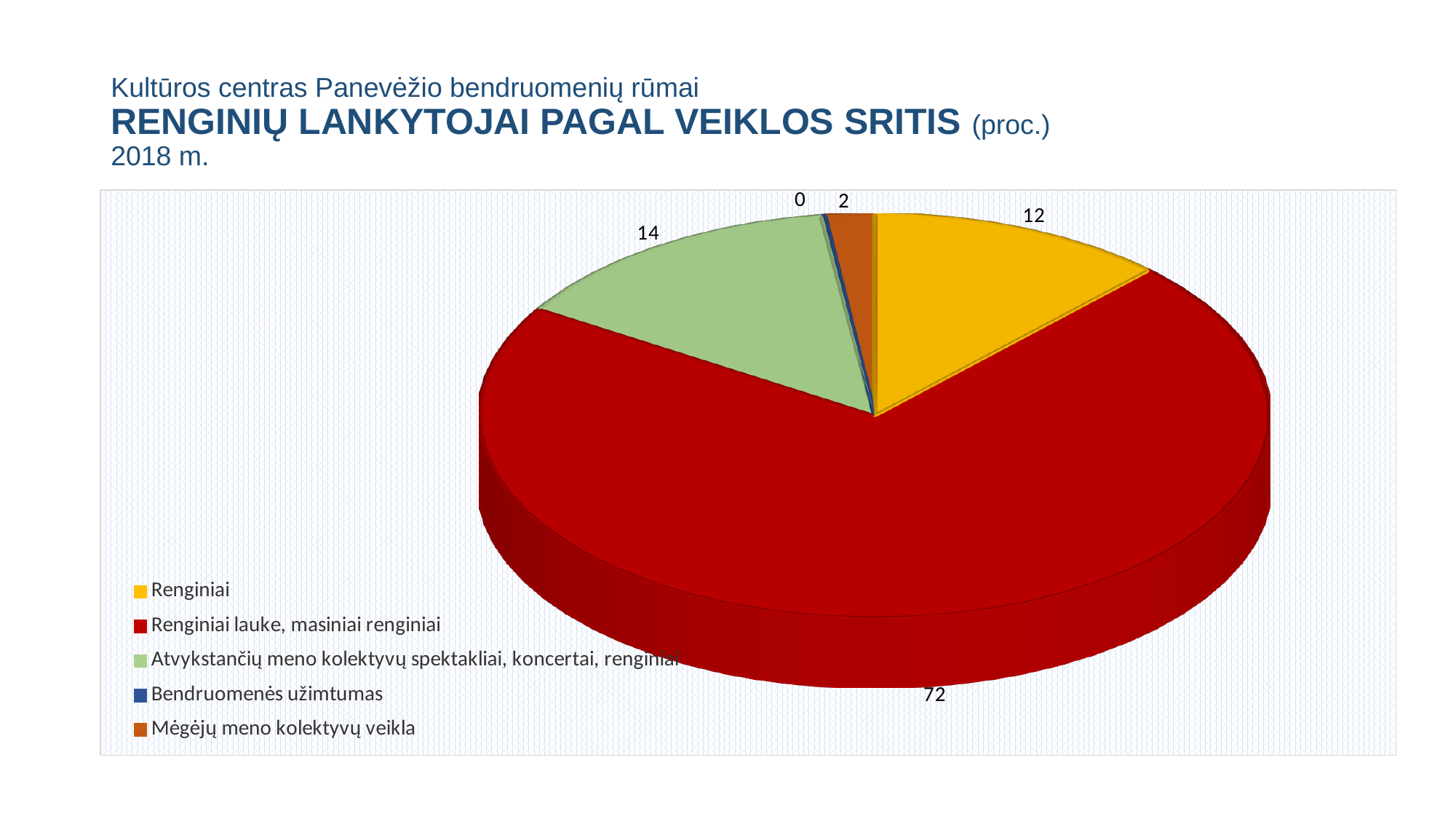
Which category has the largest share of the pie? Renginiai lauke, masiniai renginiai What is the value for Renginiai lauke, masiniai renginiai? 72 What is the difference between the values for Renginiai lauke, masiniai renginiai and Atvykstančių meno kolektyvų spektakliai, koncertai, renginiai? 58 Which category has the smallest share of the pie? Bendruomenės užimtumas What is the value for Renginiai? 12 What is the value for Bendruomenės užimtumas? 0 What colour is the slice for Renginiai? yellow Which is larger: the value for Renginiai or the value for Atvykstančių meno kolektyvų spektakliai, koncertai, renginiai? Atvykstančių meno kolektyvų spektakliai, koncertai, renginiai What is the value for Atvykstančių meno kolektyvų spektakliai, koncertai, renginiai? 14 What kind of chart is shown on the slide? pie chart What is the value for Mėgėjų meno kolektyvų veikla? 2 How many categories does the legend list? 5